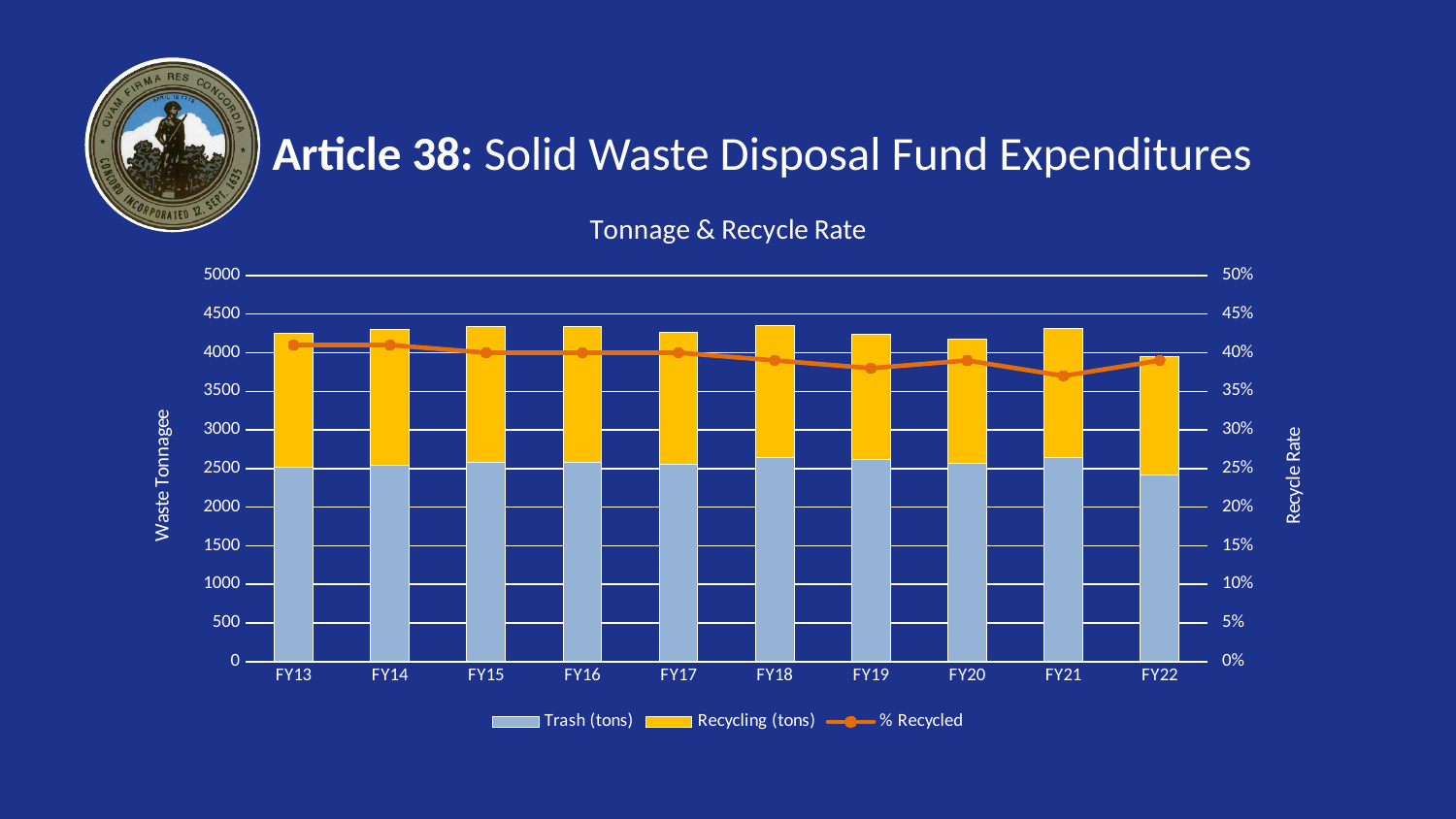
Is the % Recycled value for FY21 greater or less than 40%? less Which fiscal year has the lowest total tonnage (trash plus recycling)? FY22 How many fiscal years are shown on the x axis? 10 What type of chart is shown on the slide? Bar chart with a line Is the Trash (tons) value for FY22 greater or less than 3000? less Does the % Recycled line generally rise or fall from FY13 to FY21? fall What is the title of the chart? Tonnage & Recycle Rate Which fiscal year has the lowest % Recycled value? FY21 What is the label of the right-hand vertical axis? Recycle Rate Which is larger, the total tonnage bar for FY18 or for FY22? FY18 How many series does the legend list? 3 Is the total tonnage bar for FY18 greater or less than 4000? greater